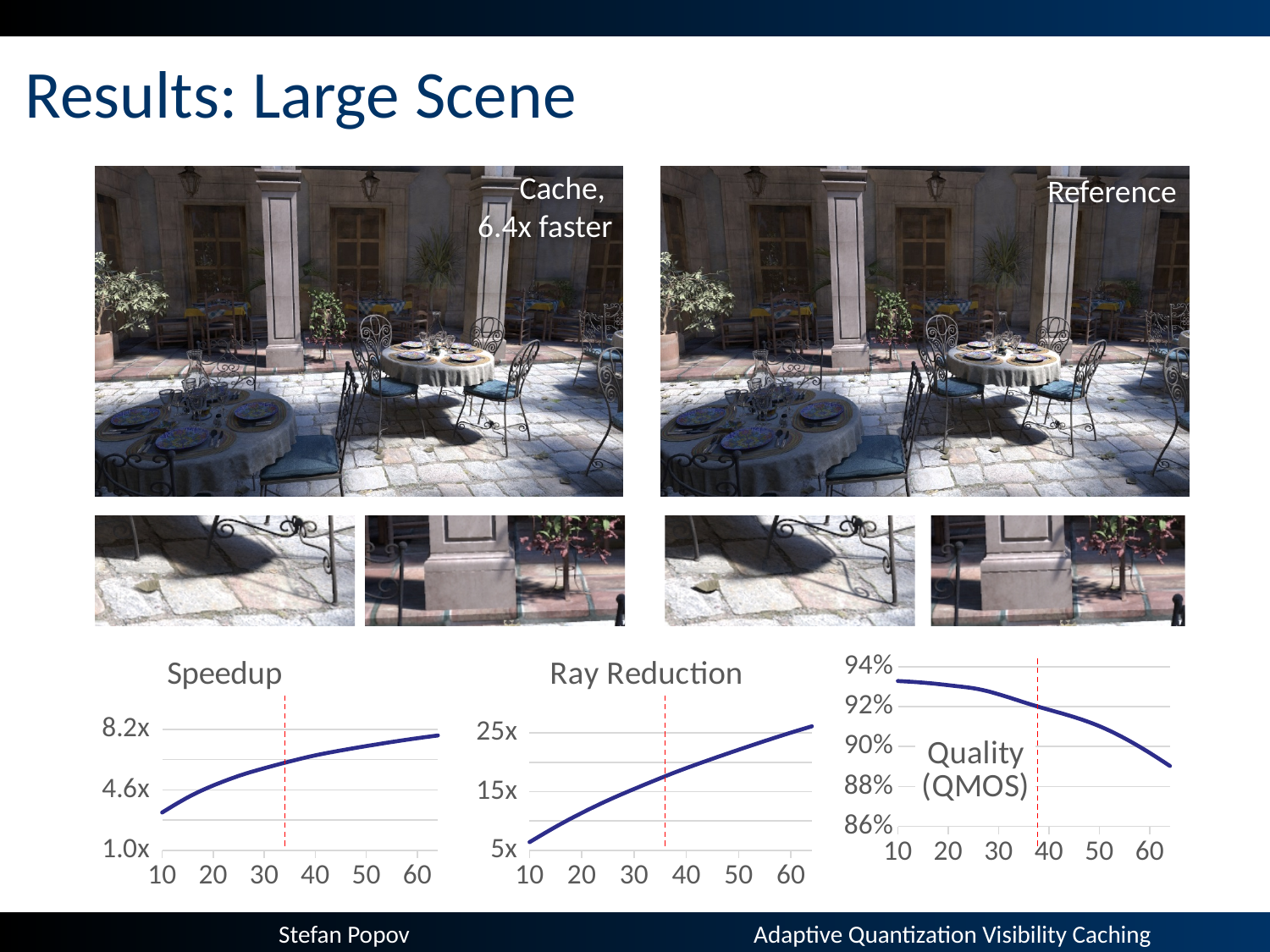
What is the title of the middle chart at the bottom of the slide? Ray Reduction What kind of chart is the Speedup chart? line chart In the Ray Reduction chart, is the value at x = 60 greater or less than 15x? greater In the Ray Reduction chart, is the value at x = 10 greater or less than 15x? less How many charts are shown at the bottom of the slide? 3 In the Ray Reduction chart, do the values rise or fall along the x axis? rise In the Speedup chart, is the value at x = 60 greater or less than 4.6x? greater In the Quality (QMOS) chart, do the values rise or fall along the x axis? fall In the Speedup chart, do the values rise or fall as the x axis increases from 10 to 60? rise